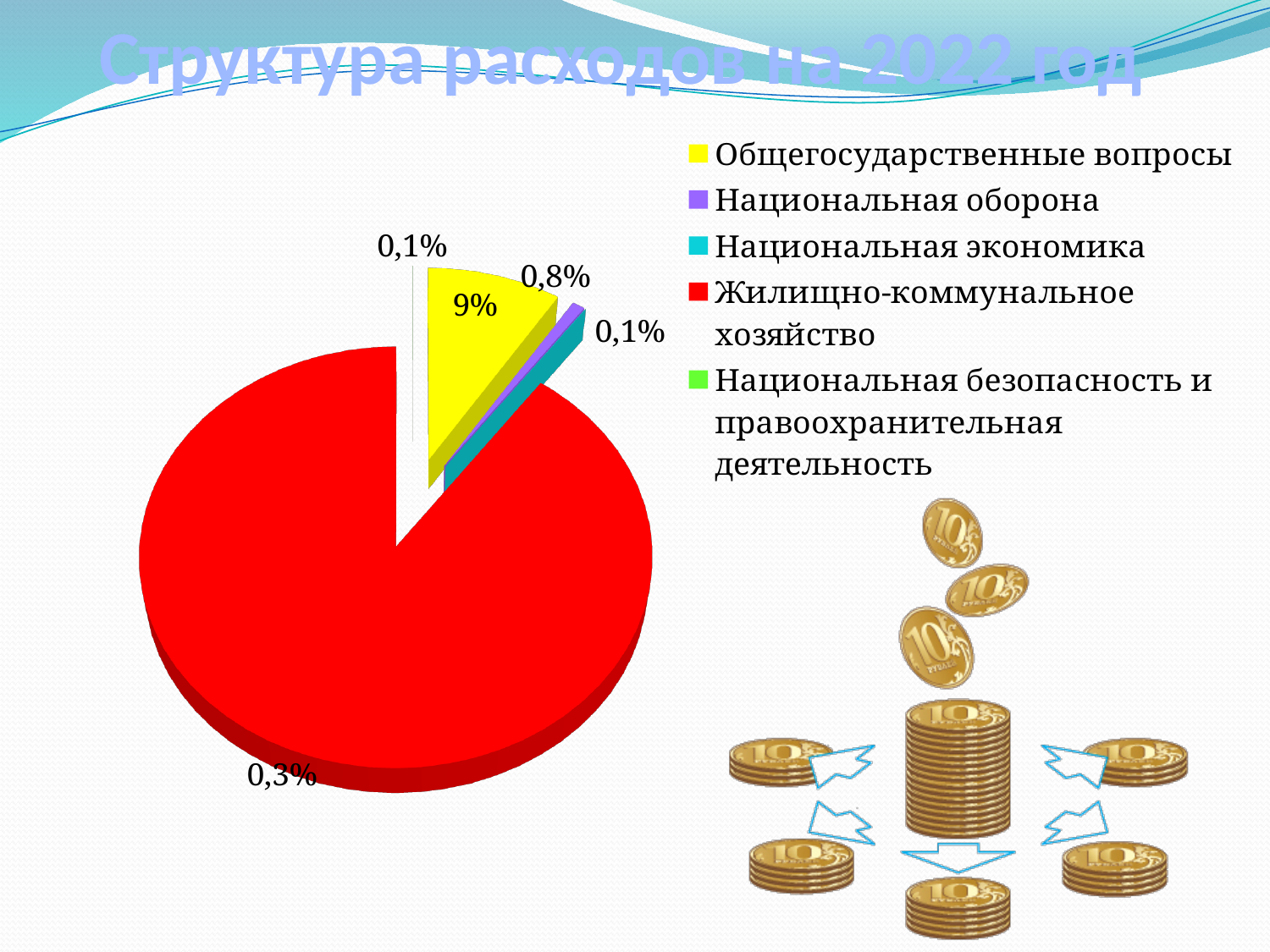
How many categories does the legend of the pie chart list? 5 What kind of chart is shown on the slide? pie chart Which category occupies the largest slice of the pie chart? Жилищно-коммунальное хозяйство What colour represents Жилищно-коммунальное хозяйство in the pie chart? red What value is labelled on the yellow slice (Общегосударственные вопросы)? 9% Which category is shown in yellow in the legend? Общегосударственные вопросы Which has the larger labelled value, Общегосударственные вопросы or Национальная оборона? Общегосударственные вопросы What value is labelled for Национальная экономика? 0,1% What is the title of the chart on the slide? Структура расходов на 2022 год What value is labelled for Национальная оборона? 0,8%